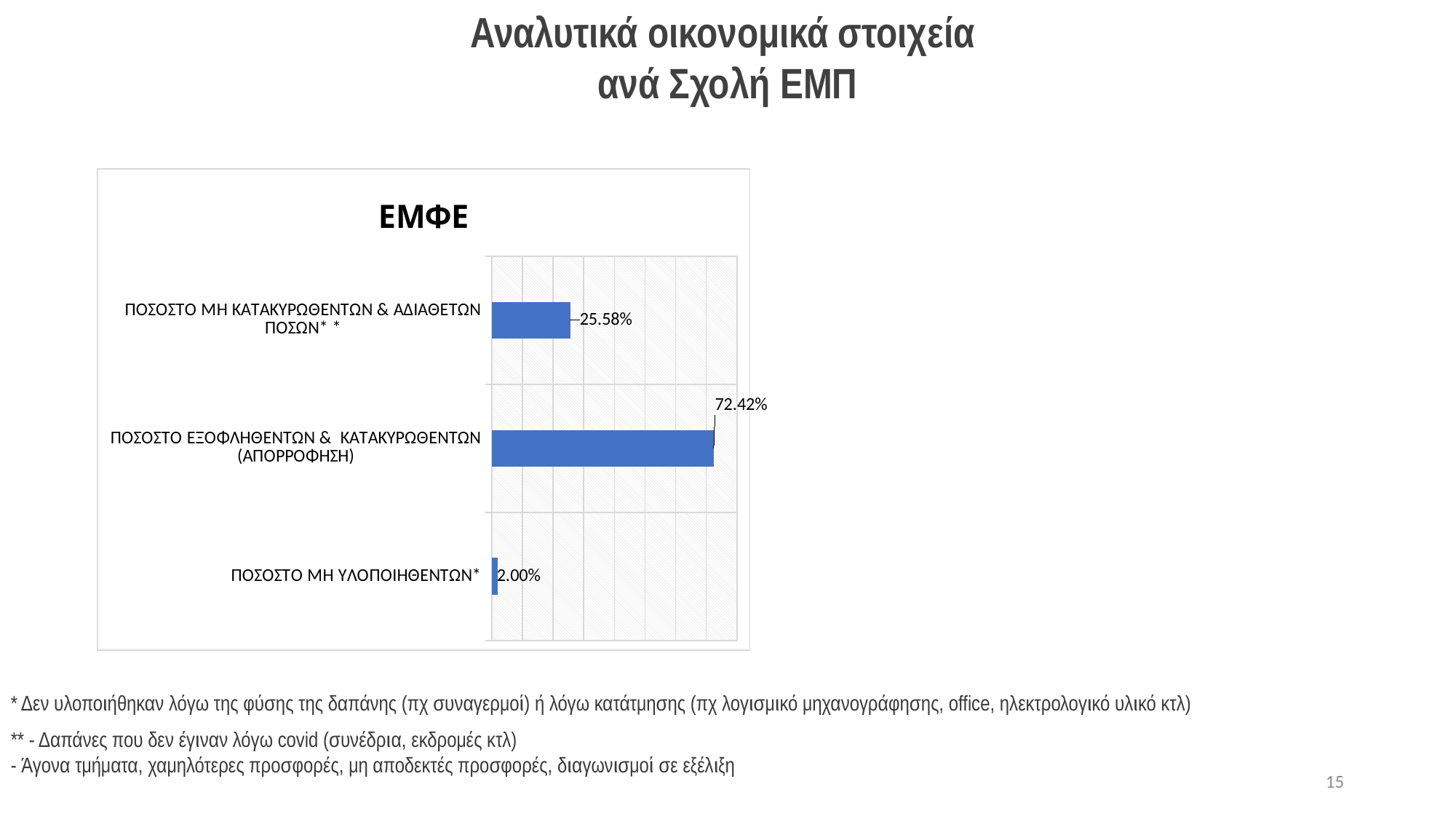
What is the title of the chart on the slide? ΕΜΦΕ Which category has the lowest value in the ΕΜΦΕ chart? ΠΟΣΟΣΤΟ ΜΗ ΥΛΟΠΟΙΗΘΕΝΤΩΝ Which category has the highest value in the ΕΜΦΕ chart? ΠΟΣΟΣΤΟ ΕΞΟΦΛΗΘΕΝΤΩΝ & ΚΑΤΑΚΥΡΩΘΕΝΤΩΝ (ΑΠΟΡΡΟΦΗΣΗ) What is the difference between the values for ΠΟΣΟΣΤΟ ΕΞΟΦΛΗΘΕΝΤΩΝ & ΚΑΤΑΚΥΡΩΘΕΝΤΩΝ (ΑΠΟΡΡΟΦΗΣΗ) and ΠΟΣΟΣΤΟ ΜΗ ΚΑΤΑΚΥΡΩΘΕΝΤΩΝ & ΑΔΙΑΘΕΤΩΝ ΠΟΣΩΝ? 46.84% What is the value for ΠΟΣΟΣΤΟ ΕΞΟΦΛΗΘΕΝΤΩΝ & ΚΑΤΑΚΥΡΩΘΕΝΤΩΝ (ΑΠΟΡΡΟΦΗΣΗ) in the ΕΜΦΕ chart? 72.42% What is the value for ΠΟΣΟΣΤΟ ΜΗ ΥΛΟΠΟΙΗΘΕΝΤΩΝ in the ΕΜΦΕ chart? 2.00% How many categories are shown in the ΕΜΦΕ chart? 3 Which is larger: the value for ΠΟΣΟΣΤΟ ΜΗ ΚΑΤΑΚΥΡΩΘΕΝΤΩΝ & ΑΔΙΑΘΕΤΩΝ ΠΟΣΩΝ or the value for ΠΟΣΟΣΤΟ ΜΗ ΥΛΟΠΟΙΗΘΕΝΤΩΝ? ΠΟΣΟΣΤΟ ΜΗ ΚΑΤΑΚΥΡΩΘΕΝΤΩΝ & ΑΔΙΑΘΕΤΩΝ ΠΟΣΩΝ What kind of chart is shown on the slide? Bar chart What is the difference between the values for ΠΟΣΟΣΤΟ ΜΗ ΚΑΤΑΚΥΡΩΘΕΝΤΩΝ & ΑΔΙΑΘΕΤΩΝ ΠΟΣΩΝ and ΠΟΣΟΣΤΟ ΜΗ ΥΛΟΠΟΙΗΘΕΝΤΩΝ? 23.58% What is the value for ΠΟΣΟΣΤΟ ΜΗ ΚΑΤΑΚΥΡΩΘΕΝΤΩΝ & ΑΔΙΑΘΕΤΩΝ ΠΟΣΩΝ in the ΕΜΦΕ chart? 25.58% What is the sum of the three values shown in the ΕΜΦΕ chart? 100.00%